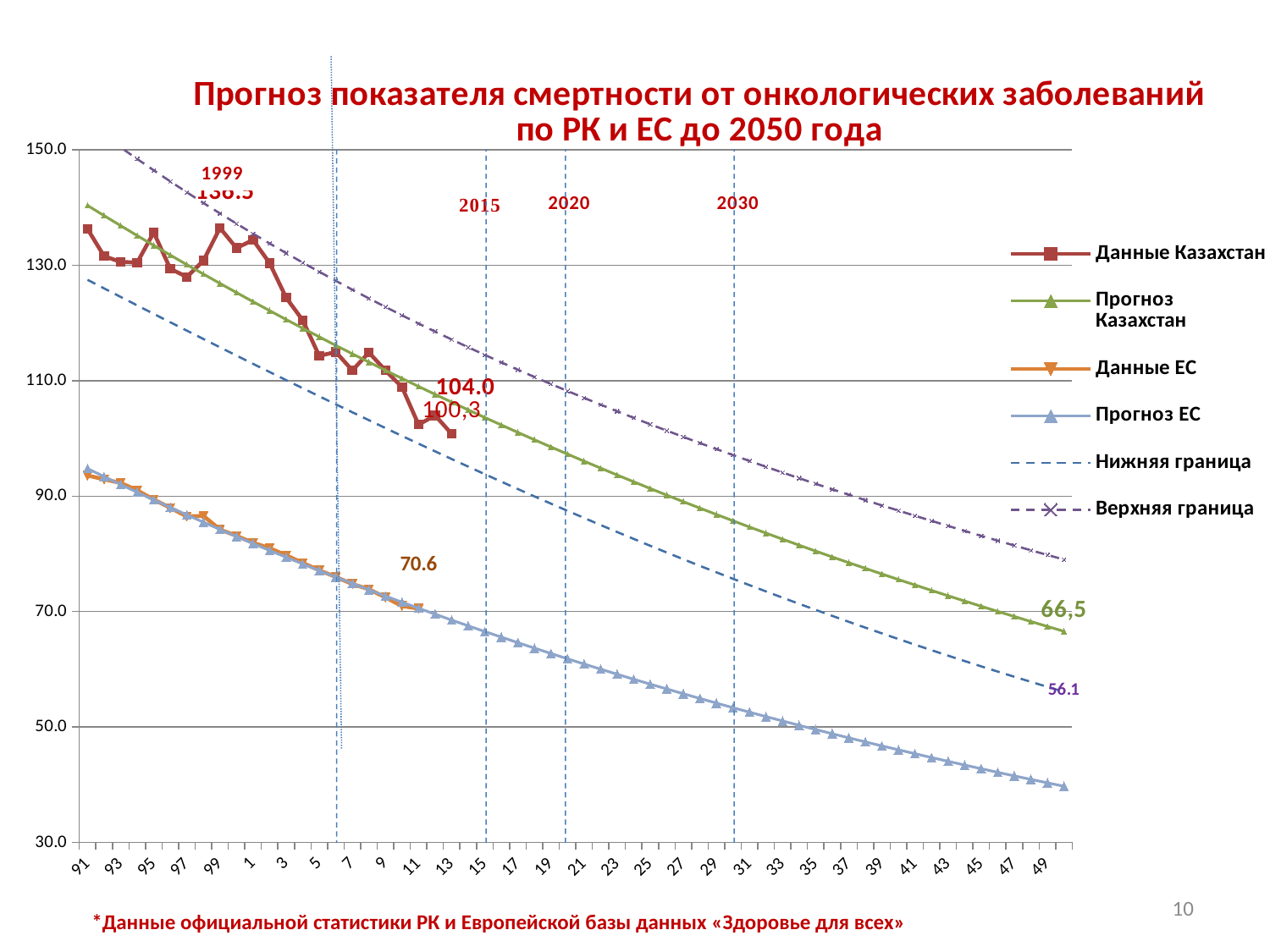
Is the first value of the Данные Казахстан series (year 91) greater or less than 130? greater Which series has the lowest values at the right end of the chart? Прогноз ЕС At the right end of the chart, which series is higher: Прогноз Казахстан or Прогноз ЕС? Прогноз Казахстан What kind of chart is shown on the slide? line chart What is the difference between the labelled end values of Прогноз Казахстан (66,5) and Нижняя граница (56.1)? 10.4 How many series does the legend list? 6 What is the title of the chart? Прогноз показателя смертности от онкологических заболеваний по РК и ЕС до 2050 года What is the labelled final value of the Нижняя граница series? 56.1 What is the labelled last value of the Данные ЕС series? 70.6 Do the values of the Прогноз Казахстан series rise or fall along the x axis? fall What is the labelled final value of the Прогноз Казахстан series at the right end of the chart? 66,5 Is the value of the Прогноз ЕС series at the far right of the chart (year 49) greater or less than 50? less